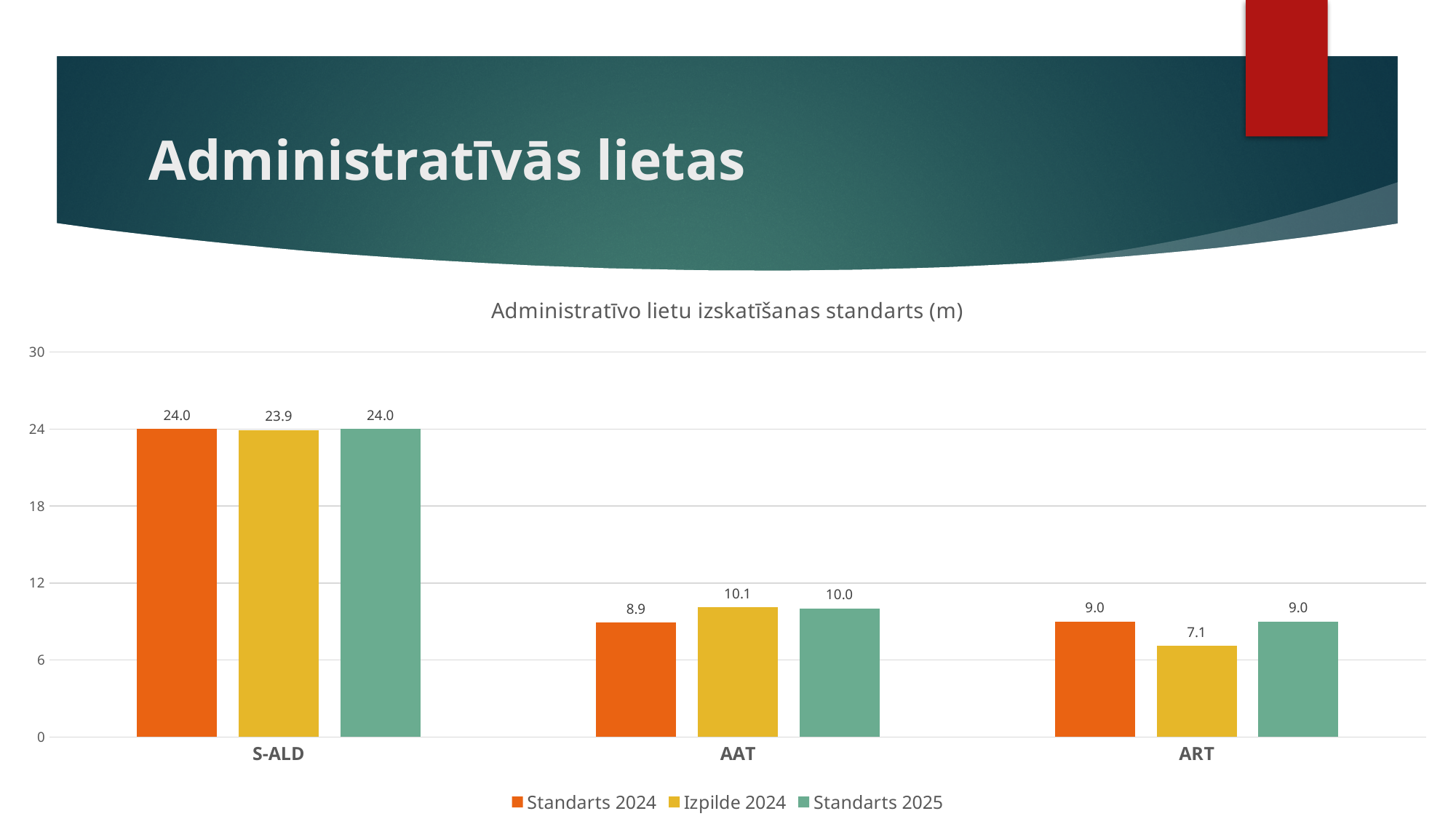
How many series does the legend list? 3 What is the value of Standarts 2024 for AAT? 8.9 What is the value of Standarts 2025 for AAT? 10.0 Which category has the highest Standarts 2024 value? S-ALD What is the value of Izpilde 2024 for ART? 7.1 Which category has the lowest Izpilde 2024 value? ART Which is larger for AAT: Izpilde 2024 or Standarts 2024? Izpilde 2024 How many categories are shown on the x axis? 3 What is the difference between Standarts 2024 and Izpilde 2024 for ART? 1.9 What is the value of Izpilde 2024 for S-ALD? 23.9 What kind of chart is shown on the slide? Bar chart What is the title of the chart? Administratīvo lietu izskatīšanas standarts (m)